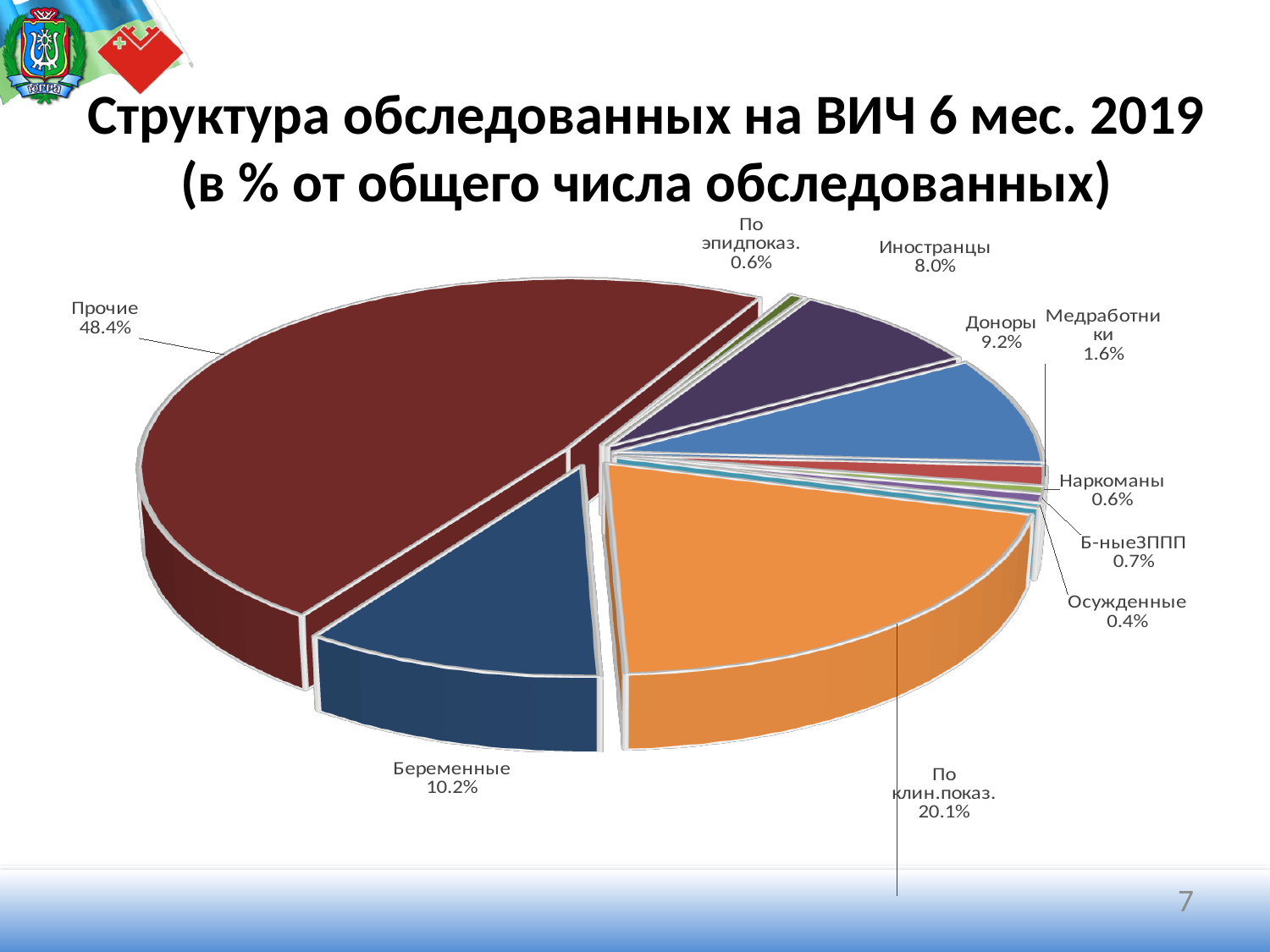
What type of chart is shown on the slide? Pie chart What is the title of the chart on the slide? Структура обследованных на ВИЧ 6 мес. 2019 (в % от общего числа обследованных) Which category has the smallest share of the pie? Осужденные What is the value for "Доноры"? 9.2% How many categories are shown in the pie chart? 10 What is the value for "Иностранцы"? 8.0% What share of the pie does the "Прочие" slice represent? 48.4% What is the difference between the shares of "По клин.показ." and "Беременные"? 9.9% Which category has the largest share of the pie? Прочие What percentage is labelled for "Беременные"? 10.2% What is the value shown for "По клин.показ."? 20.1% Which is larger, the share for "Доноры" or the share for "Иностранцы"? Доноры